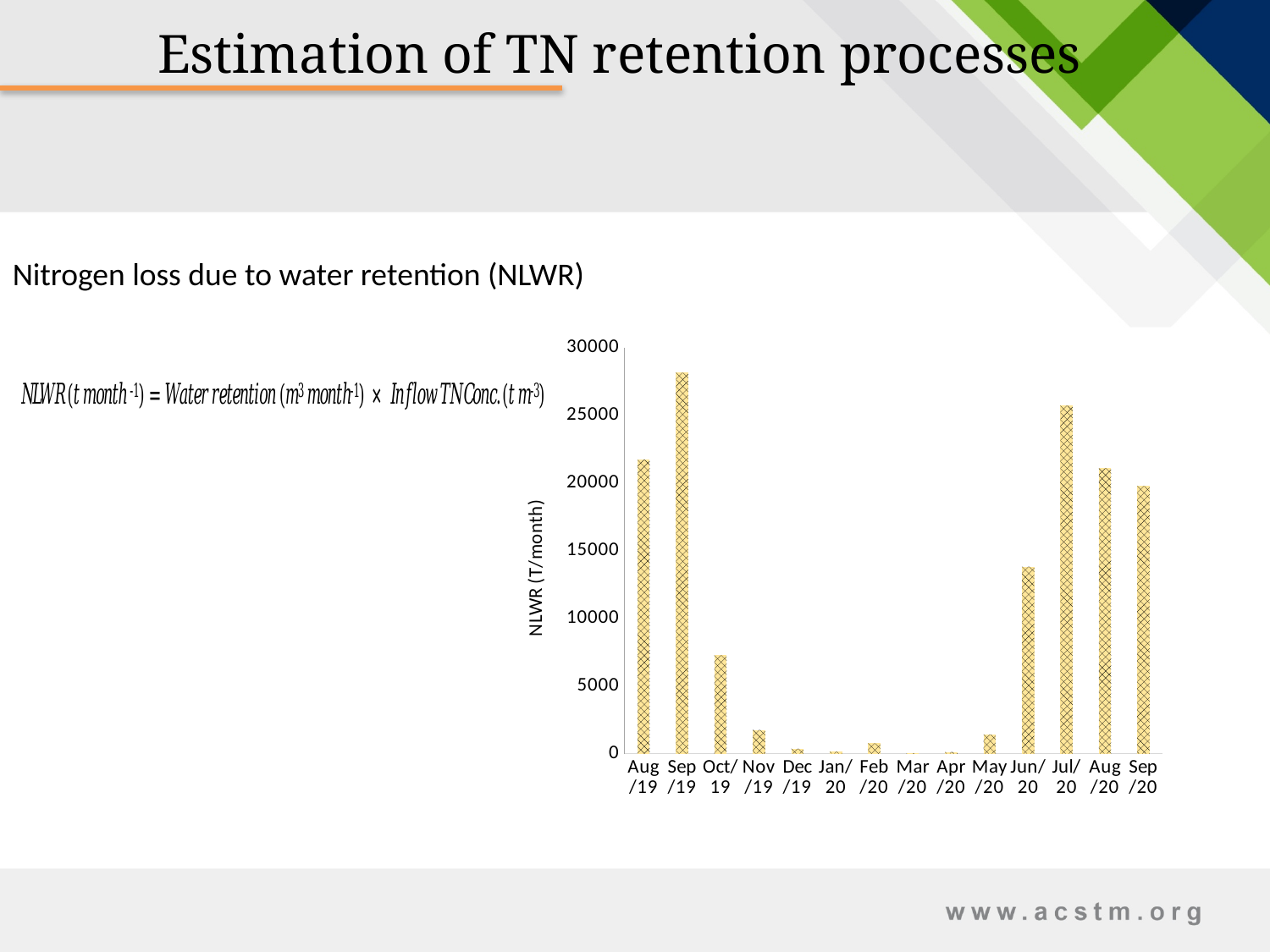
Is the NLWR value for Nov/19 greater or less than 5000? less Is the NLWR value for Jul/20 greater or less than 25000? greater Do the NLWR values rise or fall from Sep/19 to Mar/20? fall Is the NLWR value for Oct/19 greater or less than 10000? less Which has a larger NLWR value, Jun/20 or Sep/20? Sep/20 How many months are plotted on the x axis of the chart? 14 What kind of chart is shown on the slide? bar chart What is the label on the vertical axis of the chart? NLWR (T/month) Which month has the highest NLWR value in the chart? Sep/19 Which has a larger NLWR value, Sep/19 or Jul/20? Sep/19